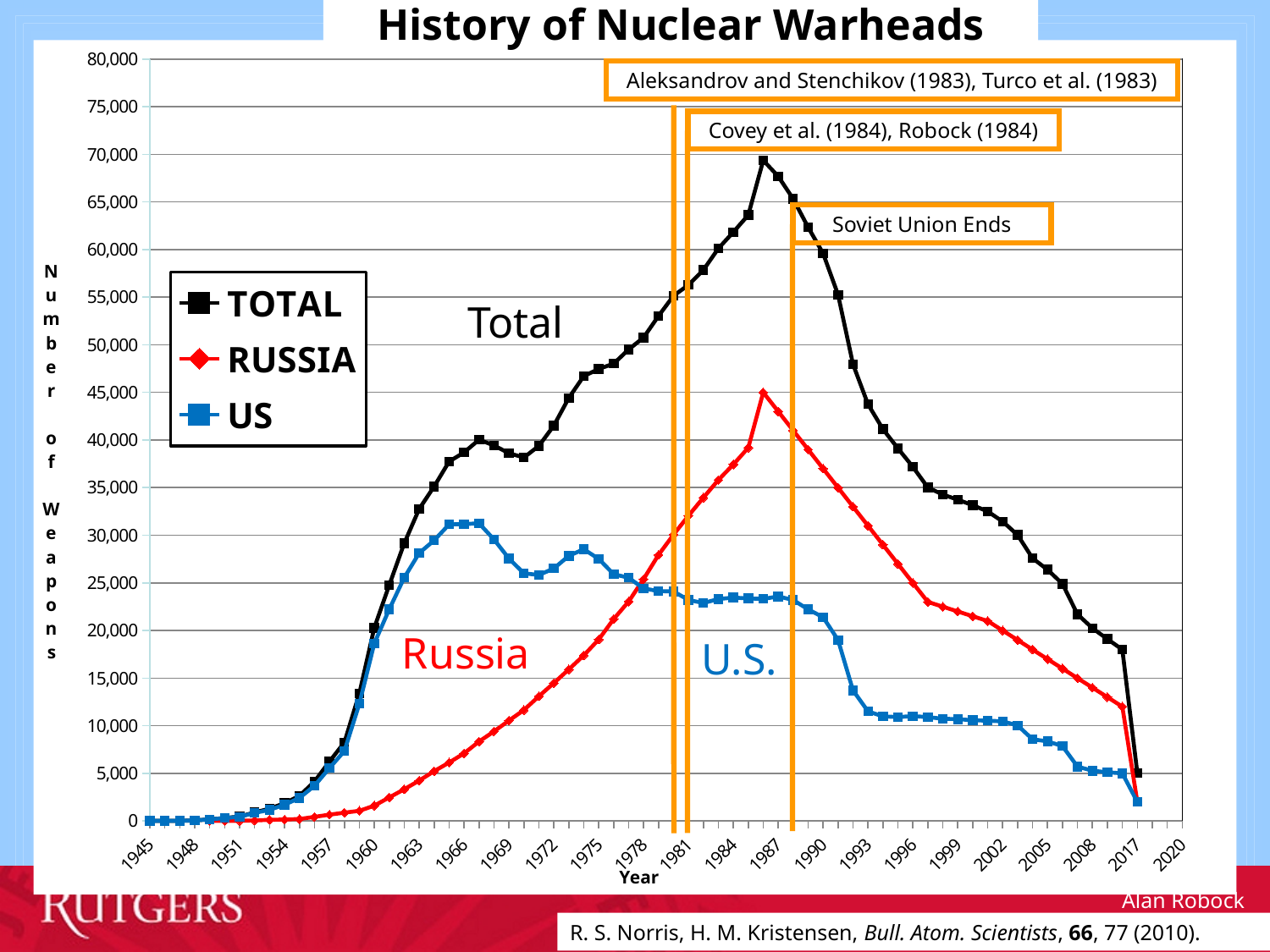
Is the peak value of the TOTAL series greater or less than 65,000? greater Is the value for US in 1993 greater or less than 15,000? less Which series is drawn in red? RUSSIA How many series does the legend list? 3 Is the value for RUSSIA in 1960 greater or less than 5,000? less Which series reaches the highest value on the chart? TOTAL Does the US series rise or fall between 1990 and 2017? fall What is the title of the chart? History of Nuclear Warheads In 1966, which series has the larger value, US or RUSSIA? US In 1990, which series has the larger value, RUSSIA or US? RUSSIA What kind of chart is shown on the slide? line chart